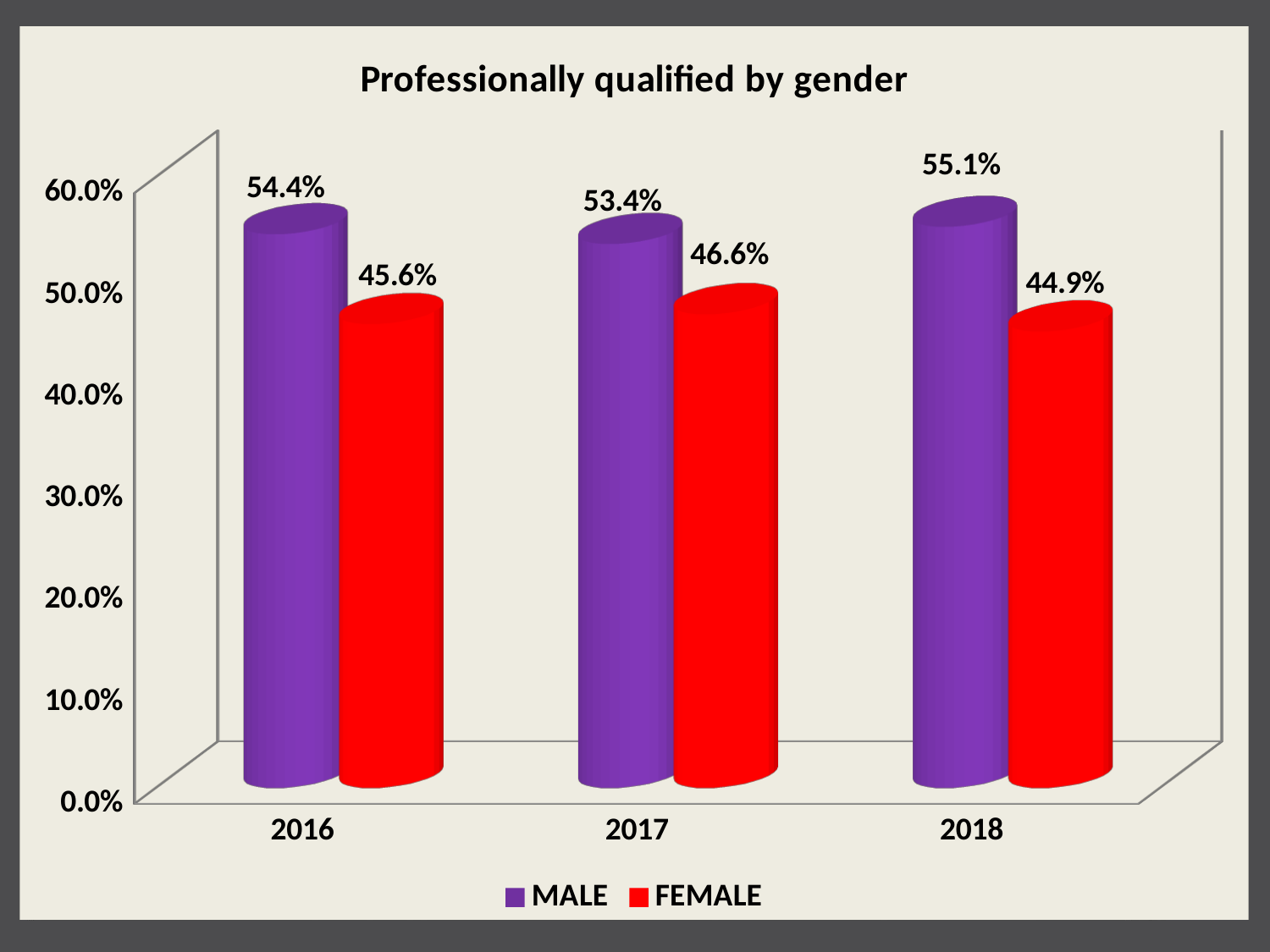
What is the difference between the MALE and FEMALE values in 2016? 8.8% What is the MALE value for 2016? 54.4% Which is larger in 2017, the MALE value or the FEMALE value? MALE Is the FEMALE value for 2016 greater or less than 50.0%? less In which year is the MALE value highest? 2018 How many years are shown on the x axis? 3 What is the title of the chart? Professionally qualified by gender What is the FEMALE value for 2017? 46.6% In which year is the FEMALE value lowest? 2018 What is the FEMALE value for 2018? 44.9% How many series does the legend list? 2 What kind of chart is this? bar chart